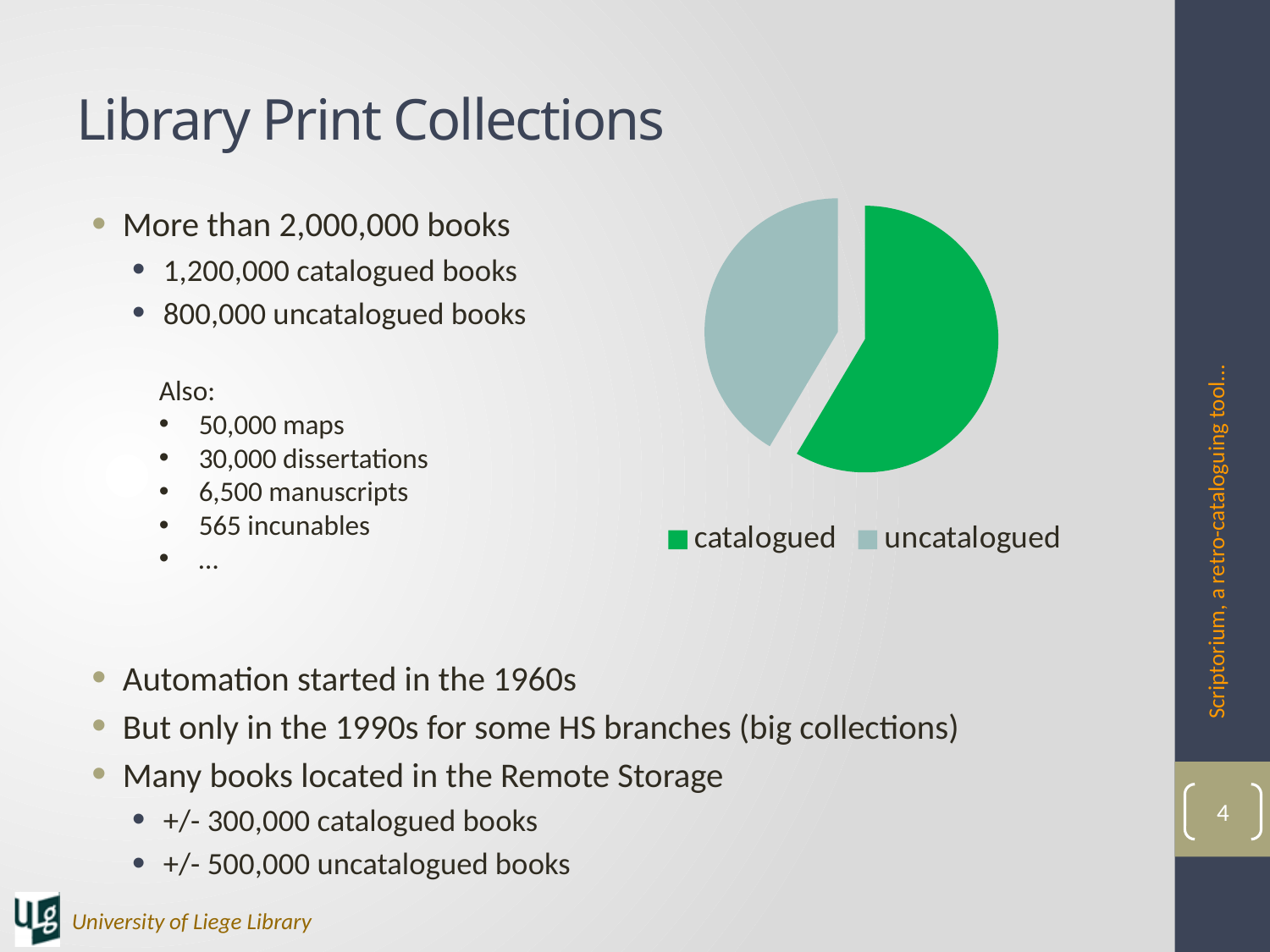
What kind of chart is shown on the slide? pie chart Does the catalogued slice take up more or less than half of the pie chart? more What are the two legend entries of the pie chart? catalogued, uncatalogued Which slice of the pie chart is the largest? catalogued How many entries does the legend of the pie chart list? 2 In the pie chart, which is larger: the catalogued slice or the uncatalogued slice? catalogued How many slices does the pie chart have? 2 Which slice of the pie chart is the smallest? uncatalogued What colour is the catalogued slice in the pie chart? green